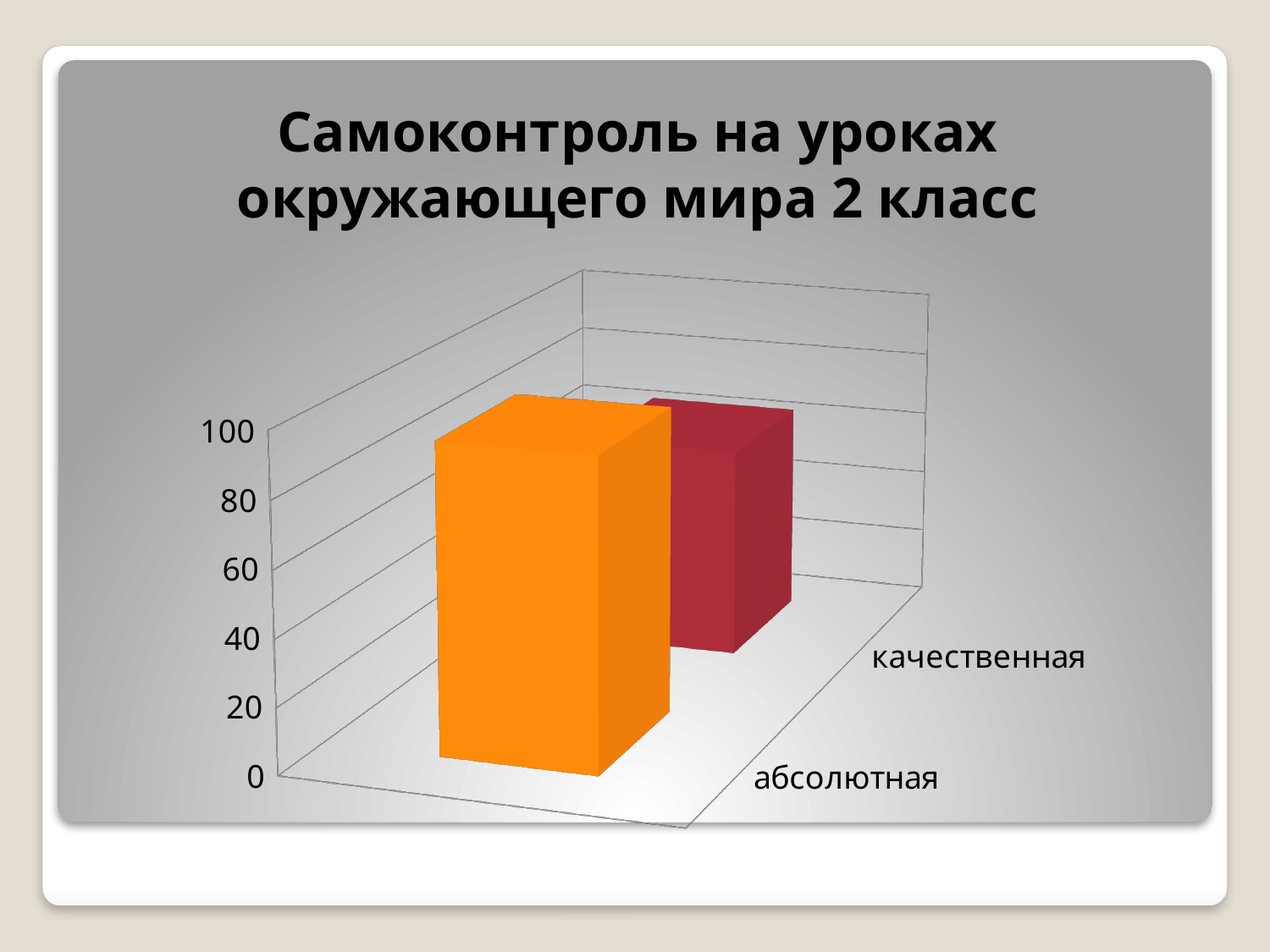
What is the highest value shown on the vertical axis? 100 What colour is the bar for абсолютная? orange Is the value for качественная greater or less than 40? greater Which is larger, the value for абсолютная or the value for качественная? абсолютная Is the value for абсолютная greater or less than 80? greater Which category has the lowest bar? качественная What kind of chart is shown on the slide? bar chart Is the value for качественная greater or less than 100? less What is the title of the chart? Самоконтроль на уроках окружающего мира 2 класс How many bars are plotted in the chart? 2 Which category has the highest bar? абсолютная